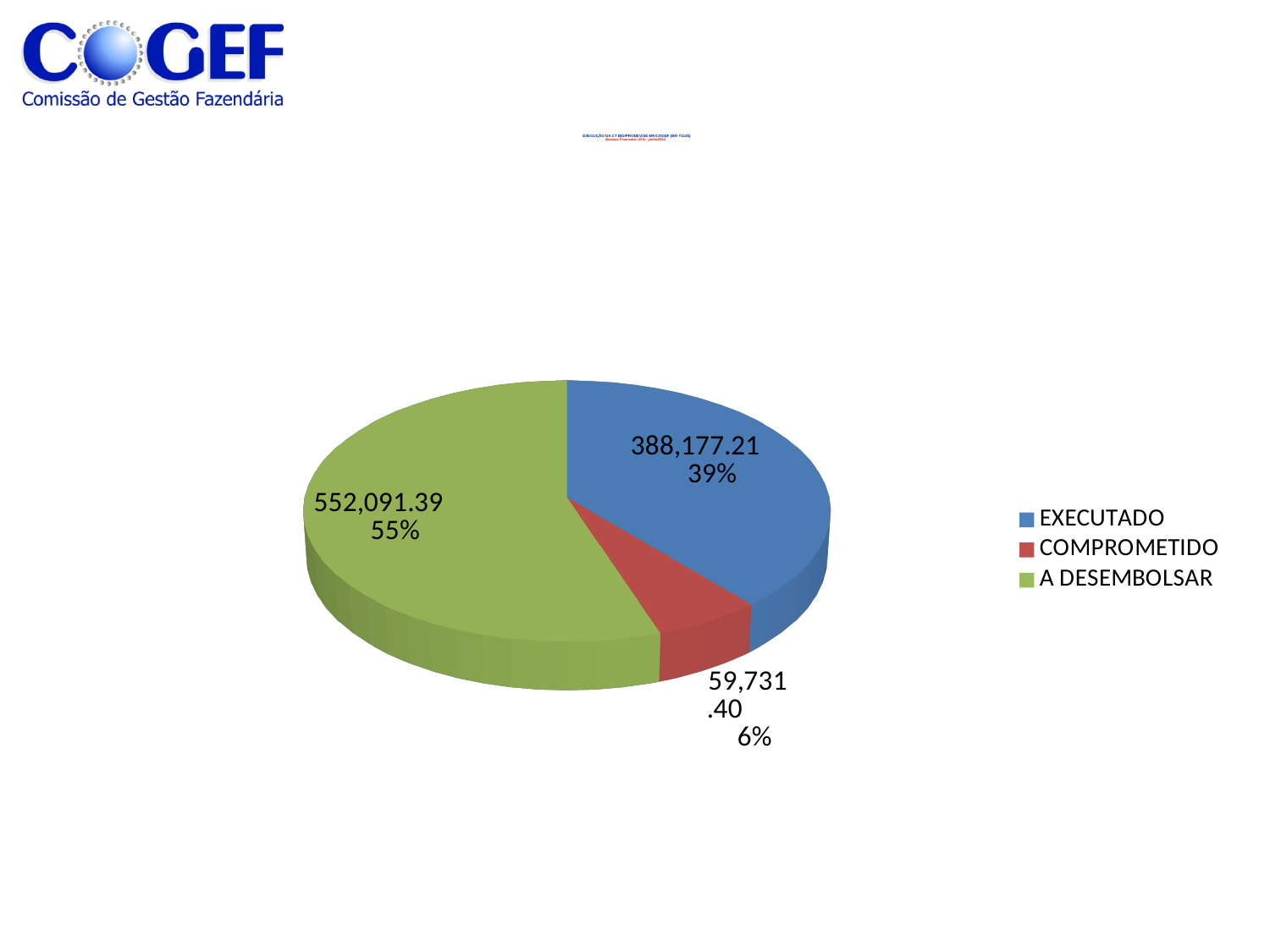
What is the value for COMPROMETIDO? 59,731.40 What share of the pie does COMPROMETIDO represent? 6% How many slices does the pie chart have? 3 What colour is the A DESEMBOLSAR slice? green What share of the pie does A DESEMBOLSAR represent? 55% What is the value for A DESEMBOLSAR? 552,091.39 What is the value for EXECUTADO? 388,177.21 Which category has the smallest slice? COMPROMETIDO Which category has the largest slice? A DESEMBOLSAR Which is larger, EXECUTADO or COMPROMETIDO? EXECUTADO What share of the pie does EXECUTADO represent? 39% What kind of chart is shown on the slide? pie chart